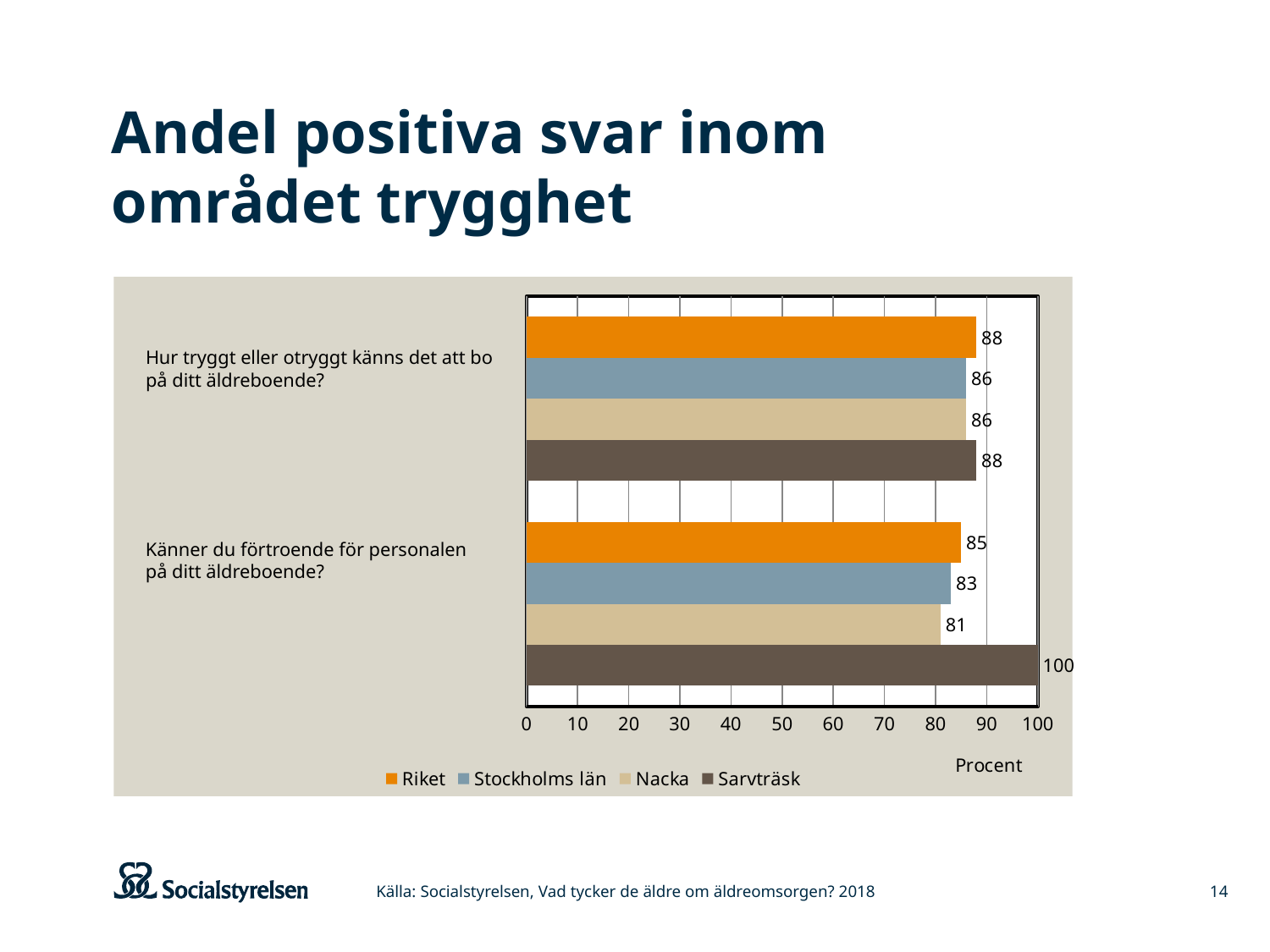
Which is larger for the question 'Känner du förtroende för personalen på ditt äldreboende?': Riket or Stockholms län? Riket What is the value for Nacka for the question 'Känner du förtroende för personalen på ditt äldreboende?' 81 What is the value for Riket for the question 'Hur tryggt eller otryggt känns det att bo på ditt äldreboende?' 88 What unit is shown on the horizontal axis of the chart? Procent What is the value for Sarvträsk for the question 'Känner du förtroende för personalen på ditt äldreboende?' 100 What kind of chart is shown on the slide? Bar chart Which series has the lowest value for the question 'Känner du förtroende för personalen på ditt äldreboende?' Nacka What is the difference between the Sarvträsk and Nacka values for the question 'Känner du förtroende för personalen på ditt äldreboende?' 19 Which series has the highest value for the question 'Känner du förtroende för personalen på ditt äldreboende?' Sarvträsk How many questions (categories) are shown on the chart? 2 What is the value for Stockholms län for the question 'Hur tryggt eller otryggt känns det att bo på ditt äldreboende?' 86 How many series does the legend list? 4